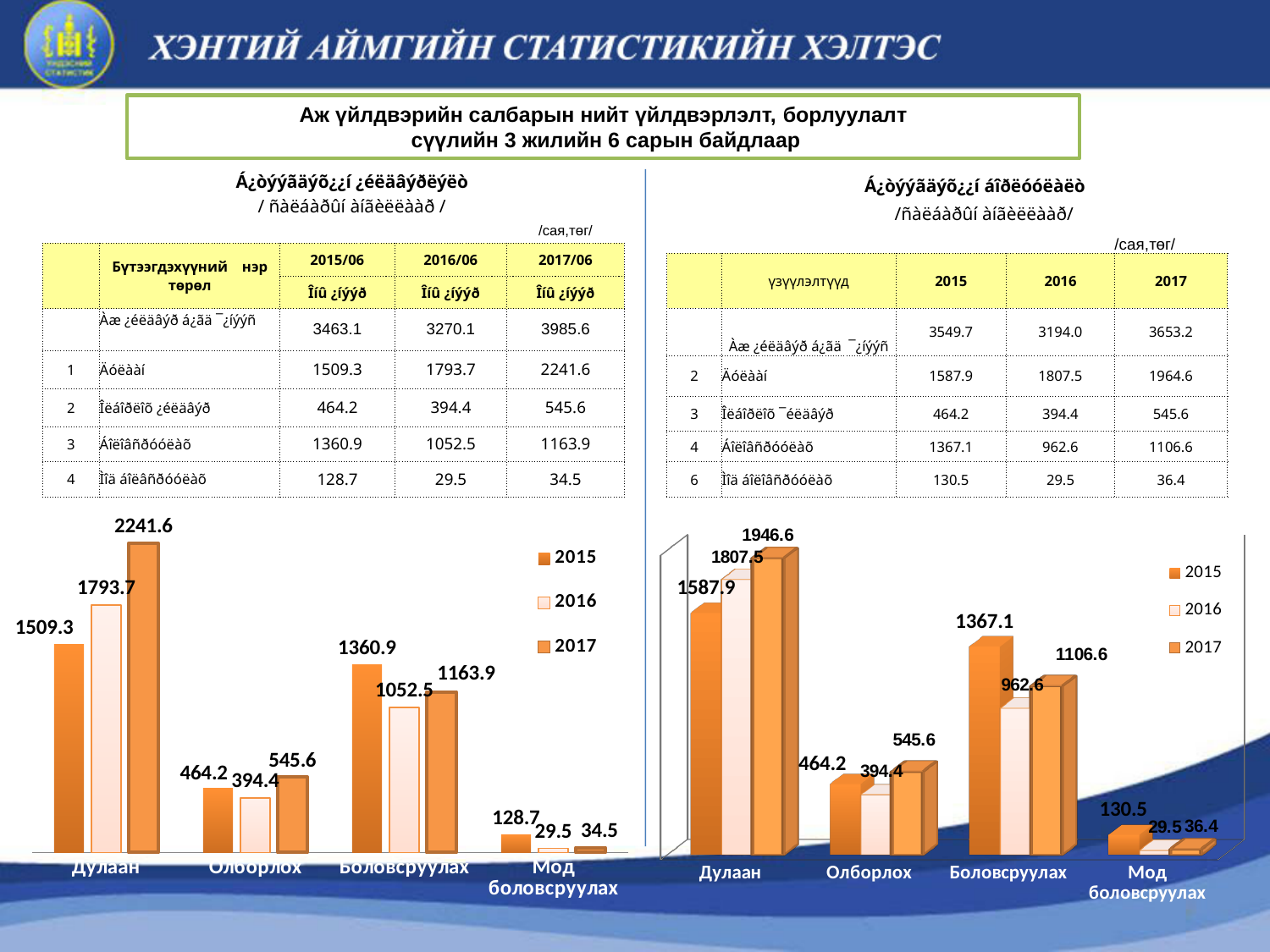
In the left chart, what is the value for Дулаан in 2017? 2241.6 What kind of chart is the chart on the right? bar chart In the right chart, which is larger for Боловсруулах: the 2015 value or the 2017 value? 2015 In the right chart, which category has the lowest value in 2017? Мод боловсруулах In the right chart, what is the value for Боловсруулах in 2016? 962.6 What are the legend entries of the left chart? 2015, 2016, 2017 How many series does the legend of the right chart list? 3 In the left chart, do the values for Дулаан rise or fall from 2015 to 2017? rise How many categories are shown on the x axis of the left chart? 4 In the right chart, what is the value for Мод боловсруулах in 2017? 36.4 In the left chart, which category has the highest value in 2015? Дулаан In the left chart, what is the difference between the 2017 and 2015 values for Дулаан? 732.3